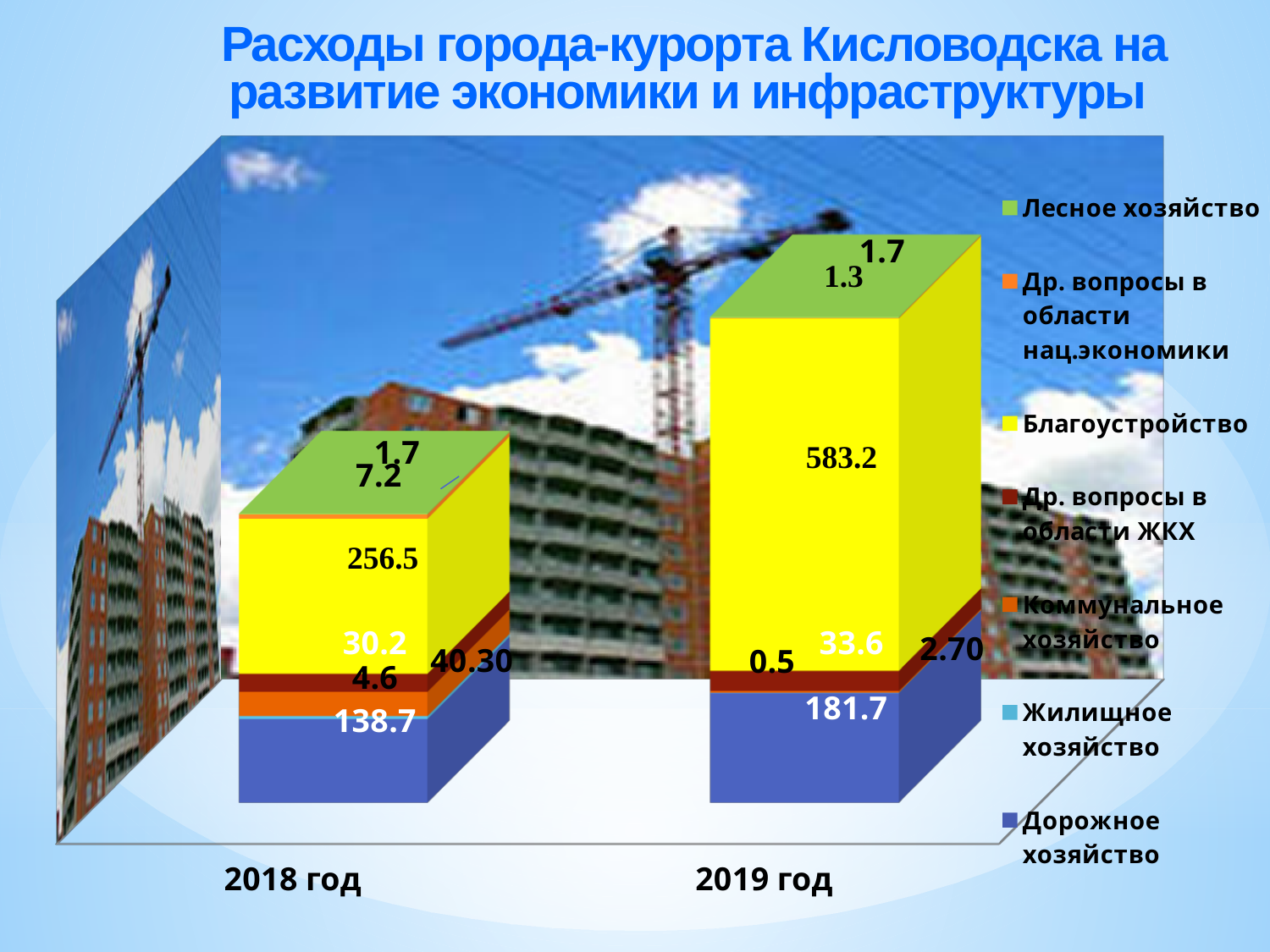
What is the value for Дорожное хозяйство in 2018 год? 138.7 What is the value for Лесное хозяйство in 2019 год? 1.7 Which year has the larger value for Благоустройство, 2018 год or 2019 год? 2019 год What is the value for Дорожное хозяйство in 2019 год? 181.7 Which series is the largest segment of the 2019 год bar? Благоустройство What is the difference in Дорожное хозяйство between 2019 год and 2018 год? 43.0 By how much did Благоустройство increase from 2018 год to 2019 год? 326.7 How many series does the chart legend list? 7 What type of chart is shown on the slide? Stacked bar chart How many years (categories) are shown on the x axis of the chart? 2 What is the value for Благоустройство in 2018 год? 256.5 What is the value for Благоустройство in 2019 год? 583.2